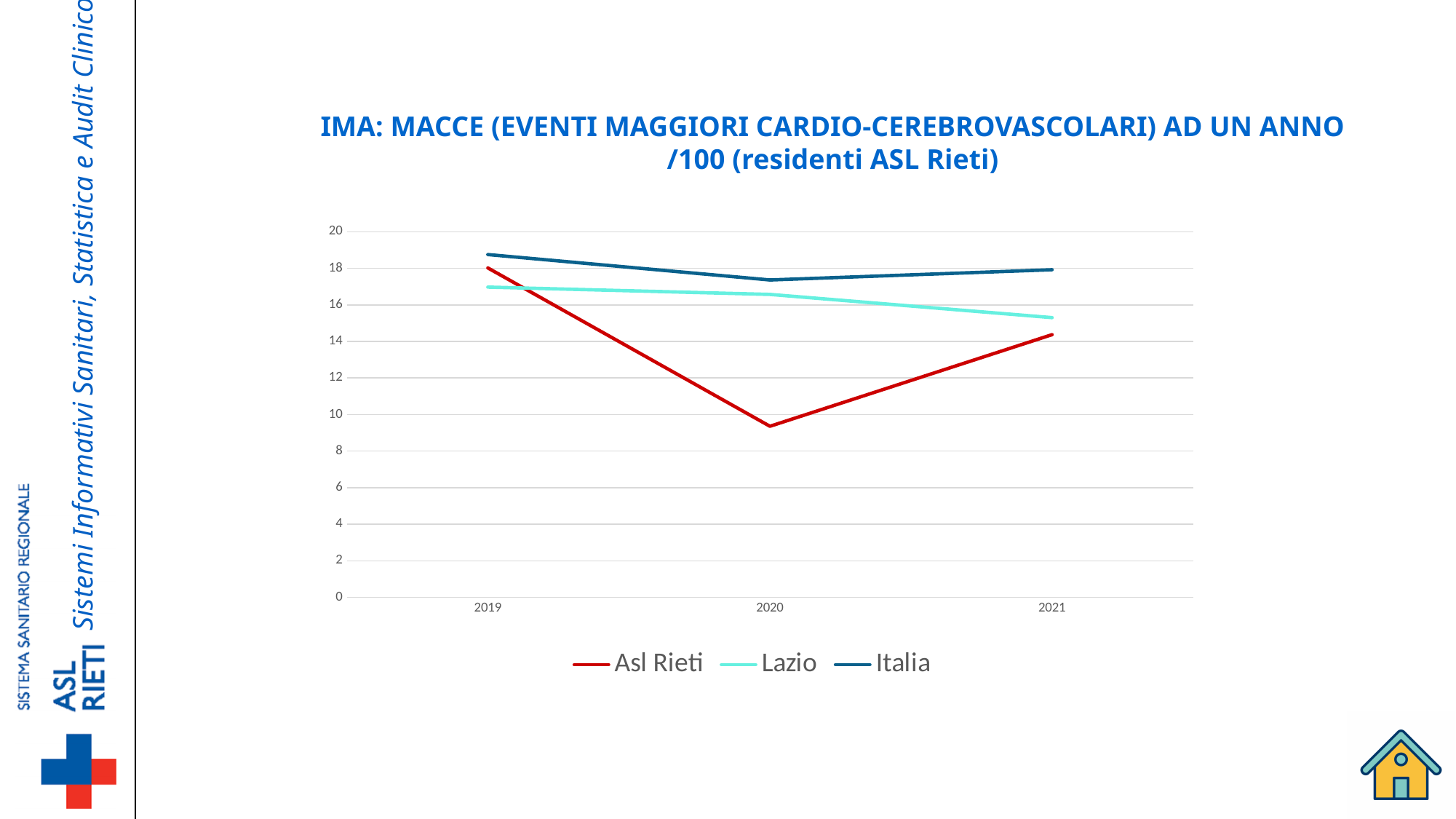
Is the value for Asl Rieti in 2020 greater or less than 10? less Does the value for Lazio rise or fall from 2019 to 2021? fall In which year is the value for Asl Rieti lowest? 2020 Is the value for Lazio in 2021 greater or less than 16? less In 2021, which series has the larger value, Lazio or Asl Rieti? Lazio Is the value for Italia in 2019 greater or less than 18? greater How many series does the legend list? 3 What kind of chart is shown on the slide? line chart In which year is the value for Italia highest? 2019 What colour is the line for Asl Rieti? red In 2020, which series has the larger value, Italia or Asl Rieti? Italia How many years are shown on the x axis? 3